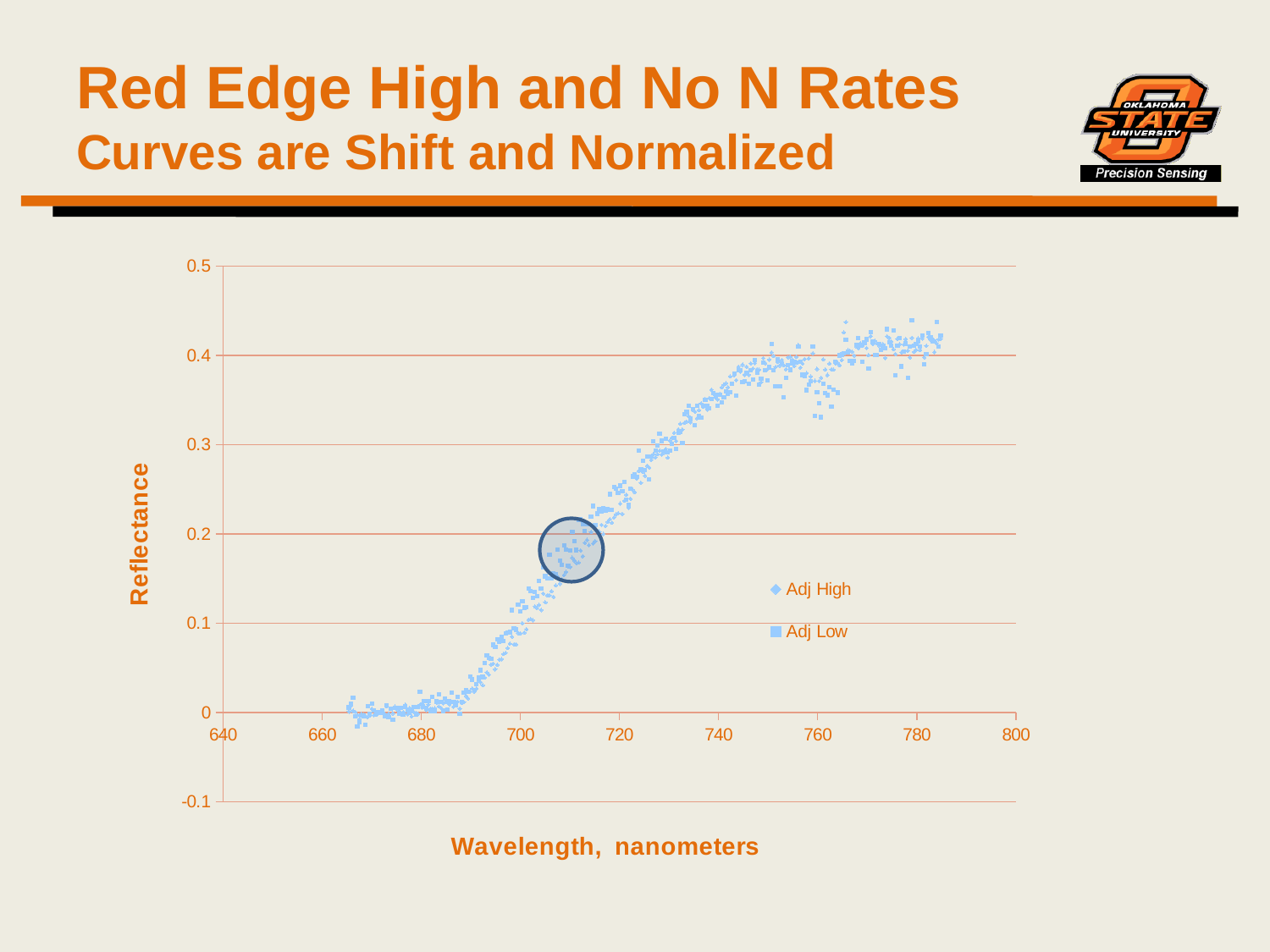
Is the reflectance at a wavelength of 740 nanometers greater or less than 0.4? less Is the reflectance at a wavelength of 720 nanometers greater or less than 0.3? less Is the reflectance at a wavelength of 740 nanometers greater or less than 0.3? greater What is the title of the x axis? Wavelength, nanometers Do the reflectance values rise or fall as wavelength increases from 680 to 760 nanometers? rise How many series does the legend list? 2 Is the reflectance higher at 760 nanometers or at 700 nanometers? 760 nanometers What are the two series named in the legend? Adj High and Adj Low What kind of chart is shown on the slide? scatter chart